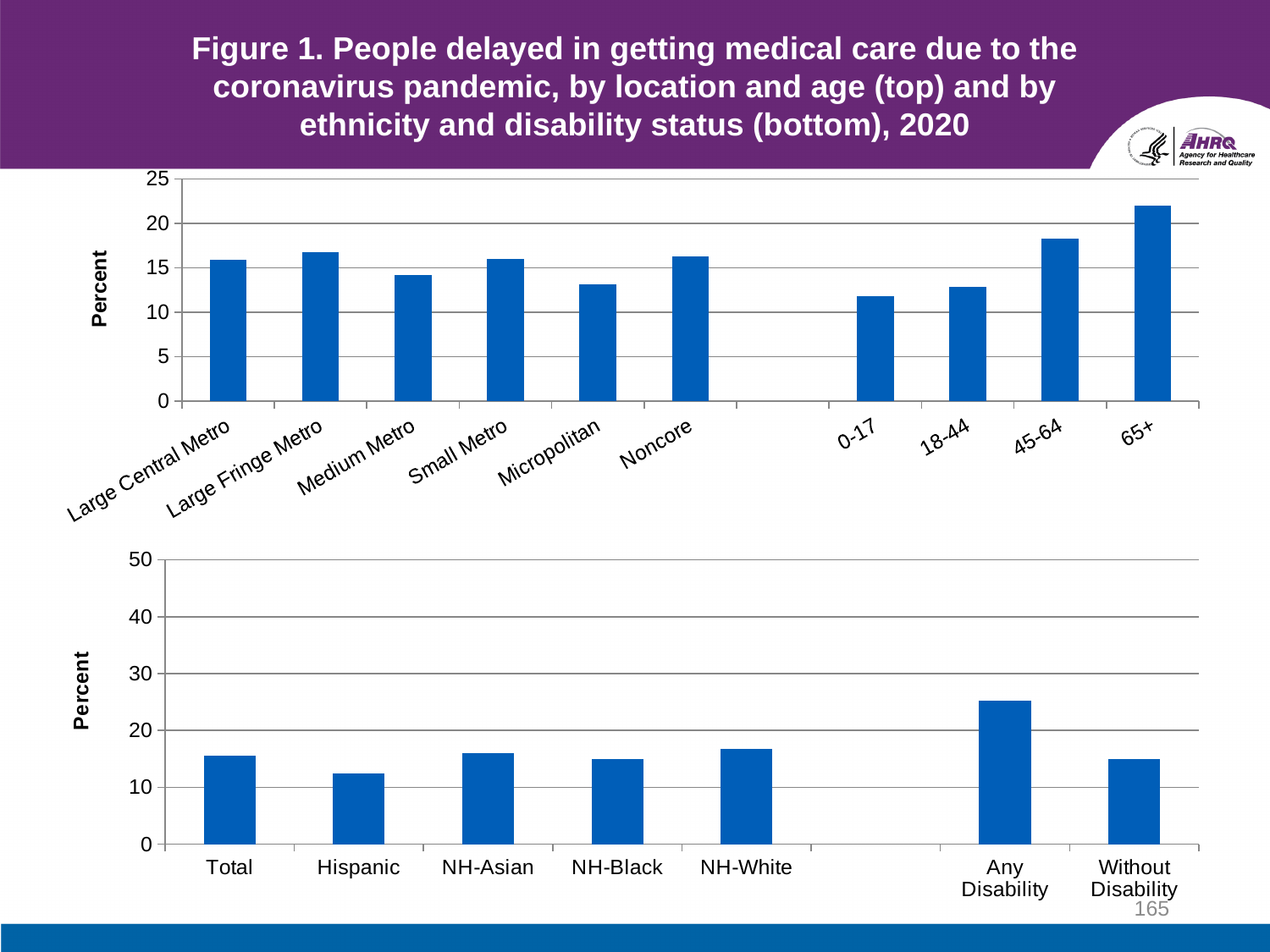
In the bottom chart, which is larger, the value for NH-White or the value for Hispanic? NH-White What kind of chart is the bottom chart? bar chart In the bottom chart, which category has the highest value? Any Disability In the bottom chart, which category has the lowest value? Hispanic In the top chart, which is larger, the value for Large Fringe Metro or the value for Medium Metro? Large Fringe Metro In the top chart, do the values rise or fall across the age groups from 0-17 to 65+? rise In the top chart, is the value for 65+ greater or less than 20? greater In the top chart, is the value for Micropolitan greater or less than 15? less In the top chart, which category has the lowest value? 0-17 How many categories are shown in the top chart? 10 In the bottom chart, is the value for Any Disability greater or less than 20? greater In the top chart, which category has the highest value? 65+